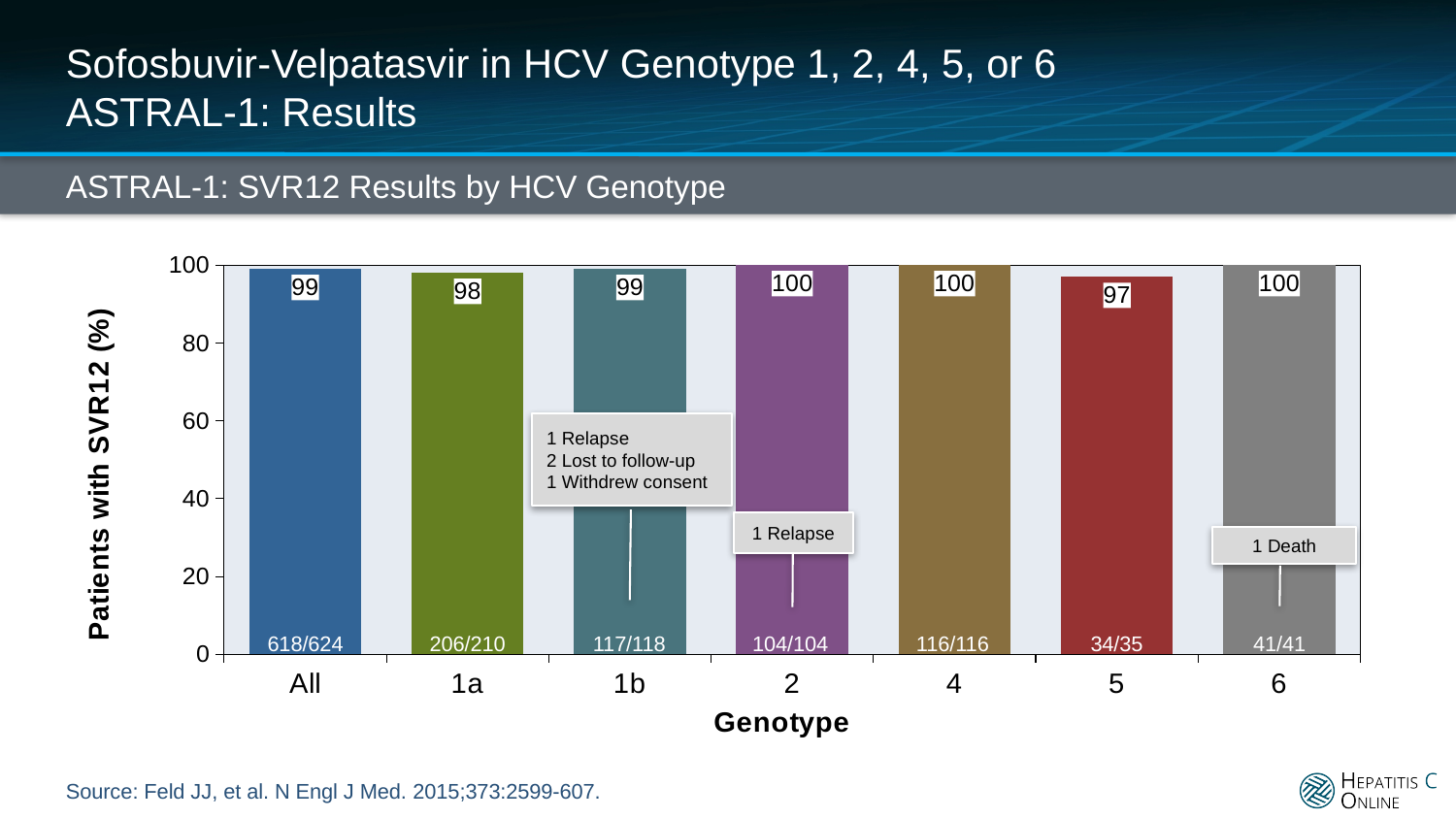
What kind of chart is shown? Bar chart What is the SVR12 rate for the All group? 99 What is the difference in SVR12 rate between genotype 2 and genotype 5? 3 How many bars are shown on the chart? 7 What is the SVR12 rate for genotype 5? 97 How many genotypes have an SVR12 rate of 100? 3 Which has a higher SVR12 rate, genotype 1a or genotype 4? Genotype 4 What is the label of the y axis? Patients with SVR12 (%) What is the SVR12 rate for genotype 1a? 98 Which genotype has the lowest SVR12 rate? 5 What reason is given in the annotation for the genotype 6 bar? 1 Death What fraction of patients is shown for genotype 1b? 117/118